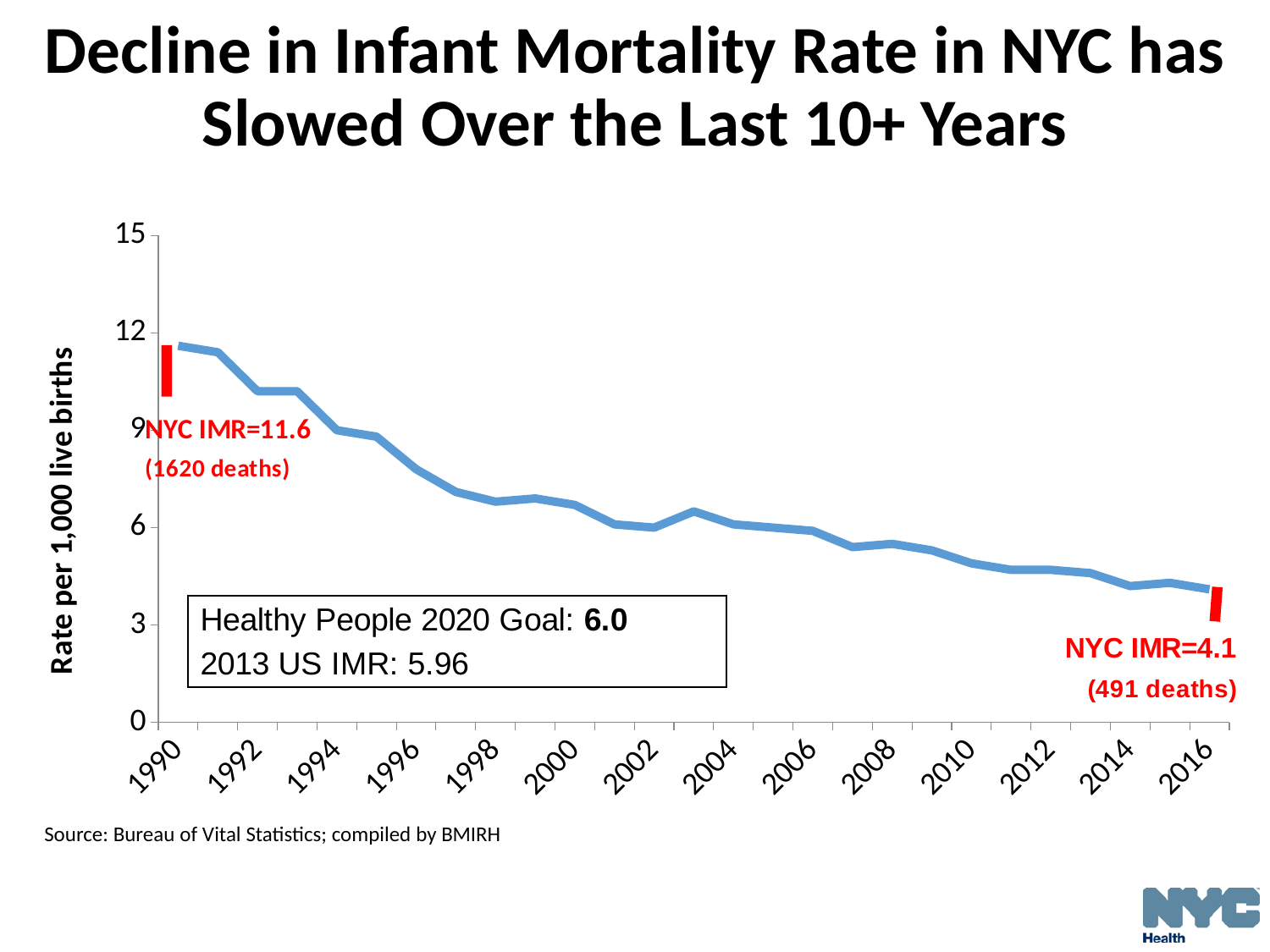
By how much did the NYC IMR fall between 1990 (11.6) and 2016 (4.1)? 7.5 What was the NYC infant mortality rate in 1990? 11.6 What was the NYC infant mortality rate in 2016? 4.1 Which year has the highest infant mortality rate on the chart? 1990 What kind of chart is shown on the slide? line chart Is the NYC IMR in 2010 greater or less than 6? less What is the label on the vertical axis? Rate per 1,000 live births Is the NYC IMR in 2000 greater or less than 6? greater How many infant deaths are noted for 2016? 491 deaths What is the Healthy People 2020 Goal shown in the box on the chart? 6.0 Which year has the lowest infant mortality rate on the chart? 2016 Does the infant mortality rate rise or fall from 1990 to 2016? fall